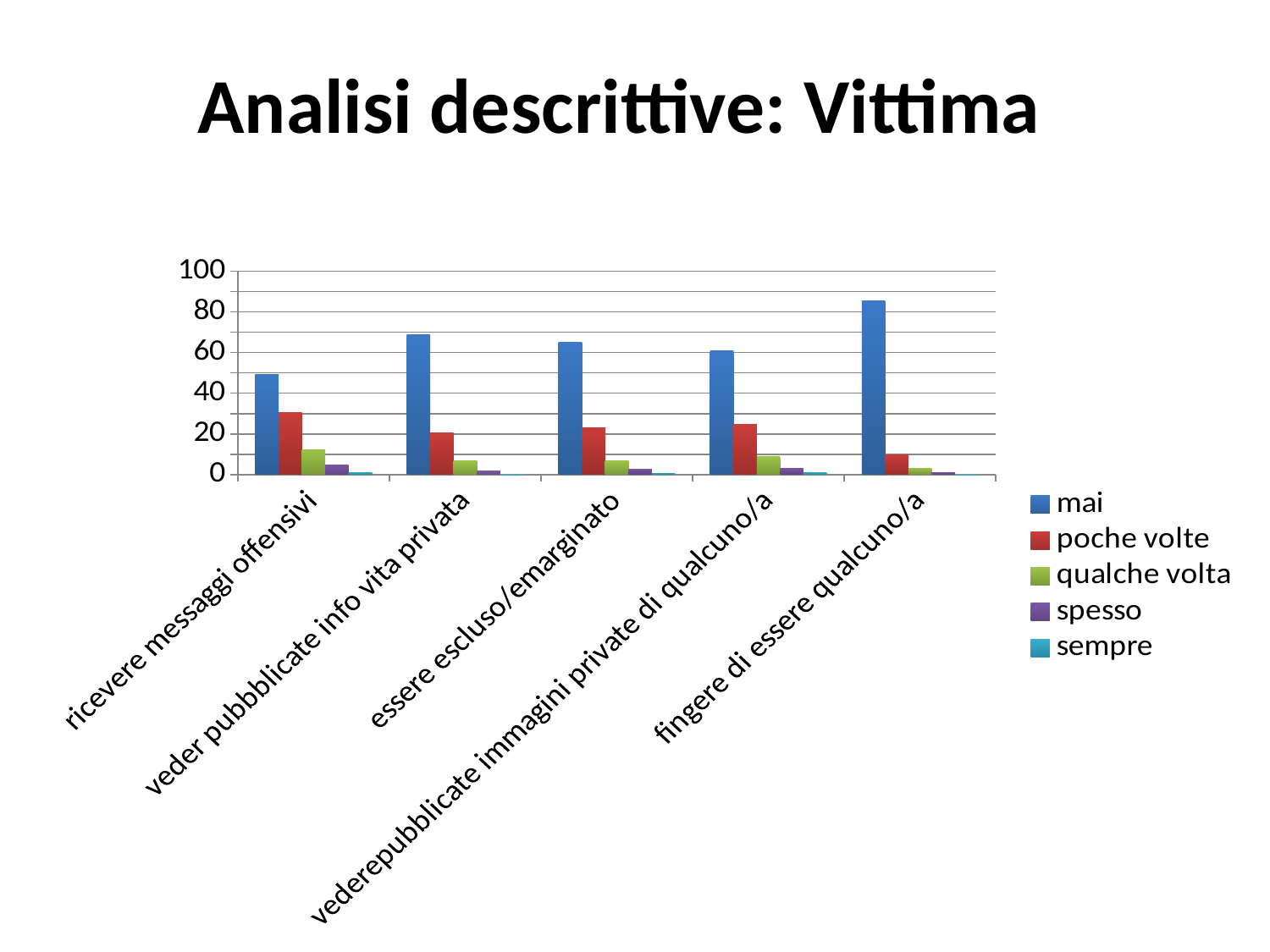
Which is larger: the 'mai' value for 'ricevere messaggi offensivi' or the 'mai' value for 'fingere di essere qualcuno/a'? fingere di essere qualcuno/a Which category has the lowest value for the 'poche volte' series? fingere di essere qualcuno/a Which category has the highest value for the 'poche volte' series? ricevere messaggi offensivi Which category has the highest value for the 'mai' series? fingere di essere qualcuno/a Is the 'mai' value for 'fingere di essere qualcuno/a' greater or less than 80? greater Which category has the lowest value for the 'mai' series? ricevere messaggi offensivi What is the title of the slide containing the chart? Analisi descrittive: Vittima How many series does the legend list? 5 What kind of chart is shown on the slide? bar chart Is the 'mai' value for 'ricevere messaggi offensivi' greater or less than 60? less How many categories are shown on the x axis of the chart? 5 Is the 'poche volte' value for 'ricevere messaggi offensivi' greater or less than 20? greater